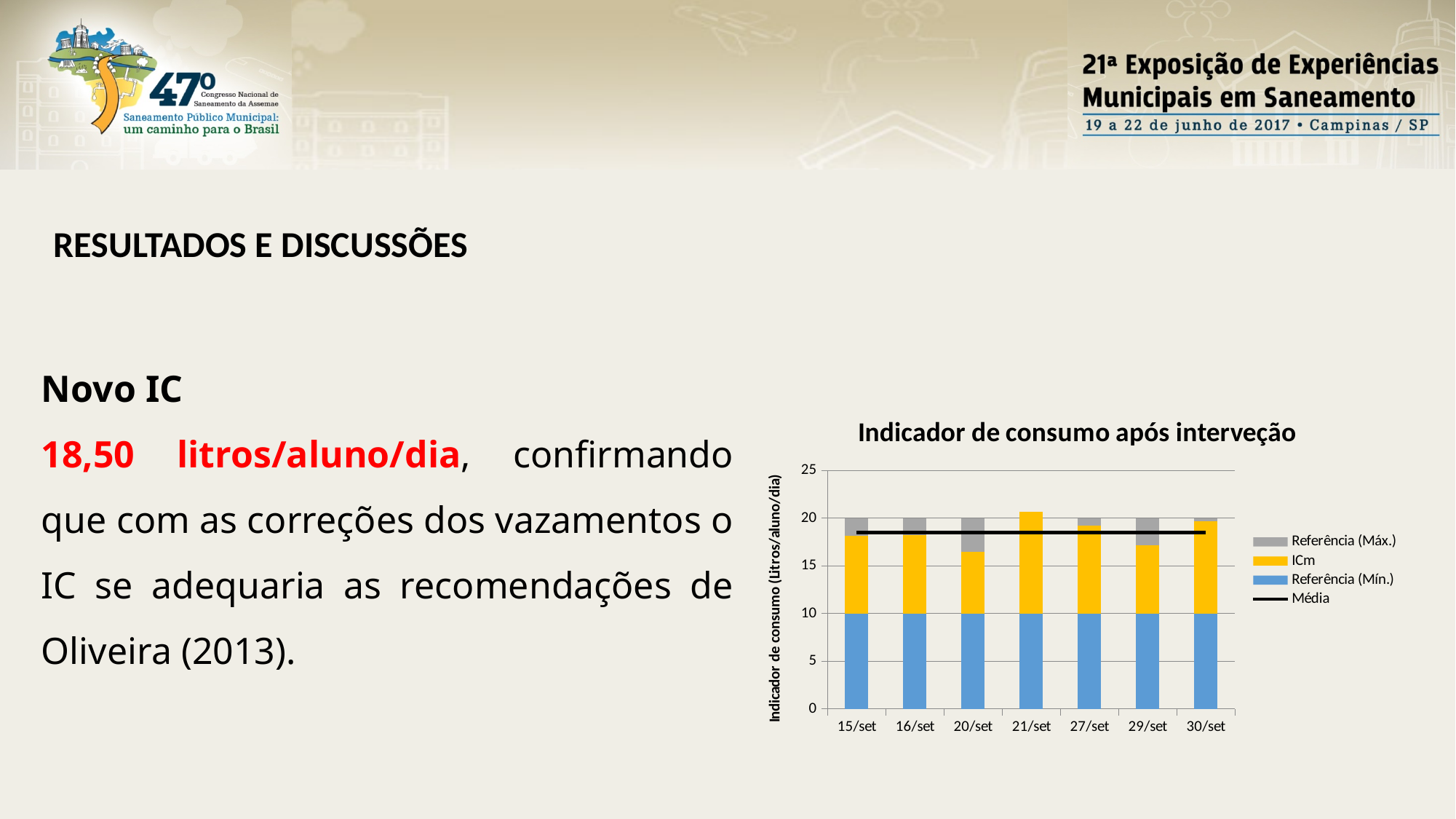
What is the Referência (Mín.) value for 15/set? 10 Is the Média line greater or less than 20? less Is the Referência (Mín.) value for 16/set greater or less than 15? less Is the top of the ICm segment for 20/set greater or less than 15? greater How many dates are shown on the x axis of the chart? 7 What is the label of the vertical axis of the chart? Indicador de consumo (Litros/aluno/dia) What is the title of the chart? Indicador de consumo após interveção What is the Referência (Mín.) value for 30/set? 10 How many entries does the chart legend list? 4 What type of chart is shown on the slide? Stacked bar chart